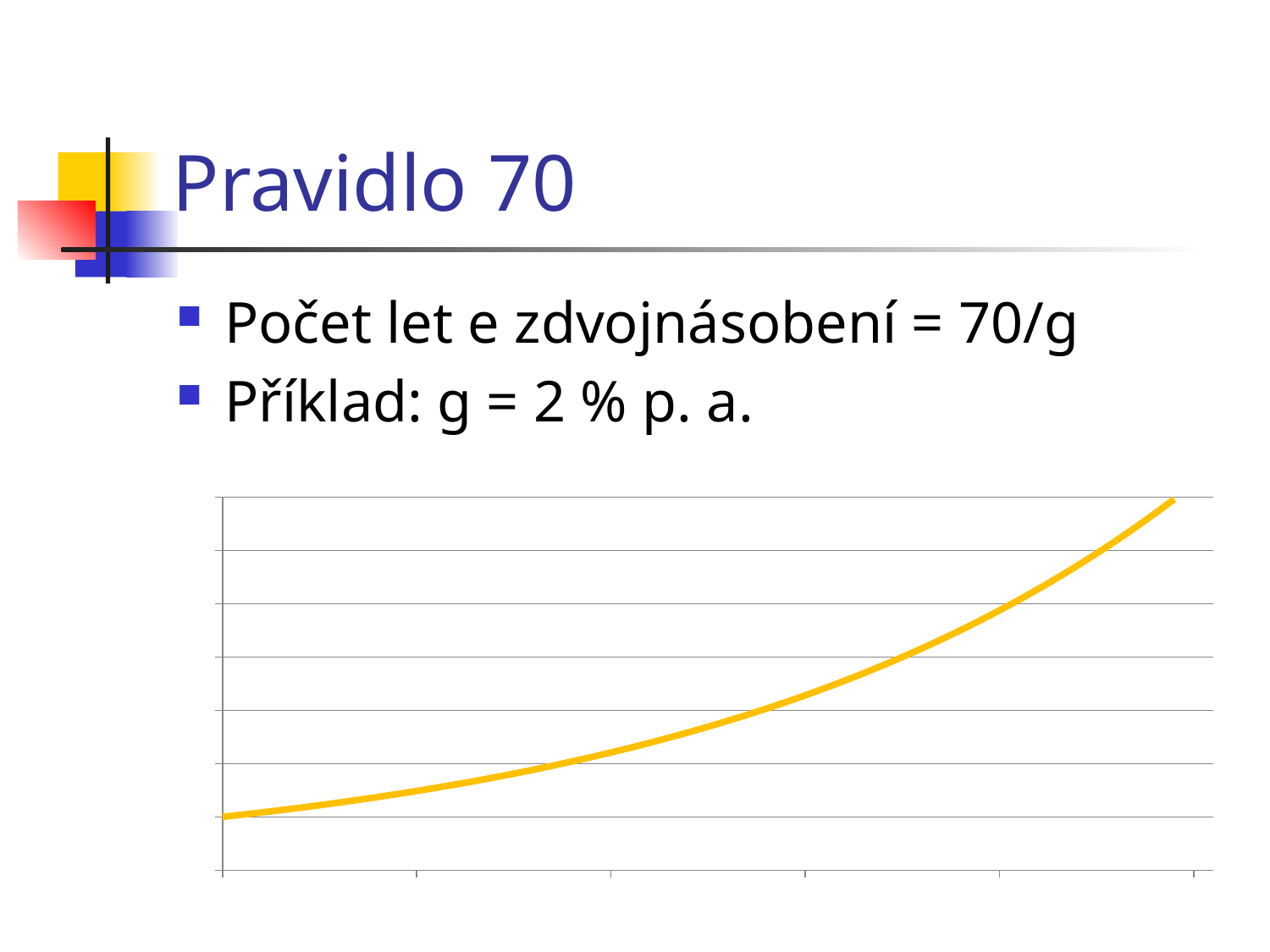
Do the values of the plotted line rise or fall from left to right along the x axis? rise How many lines are plotted on the chart? 1 What kind of chart is shown on the slide? line chart Does the chart have a legend? no What colour is the plotted line on the chart? yellow